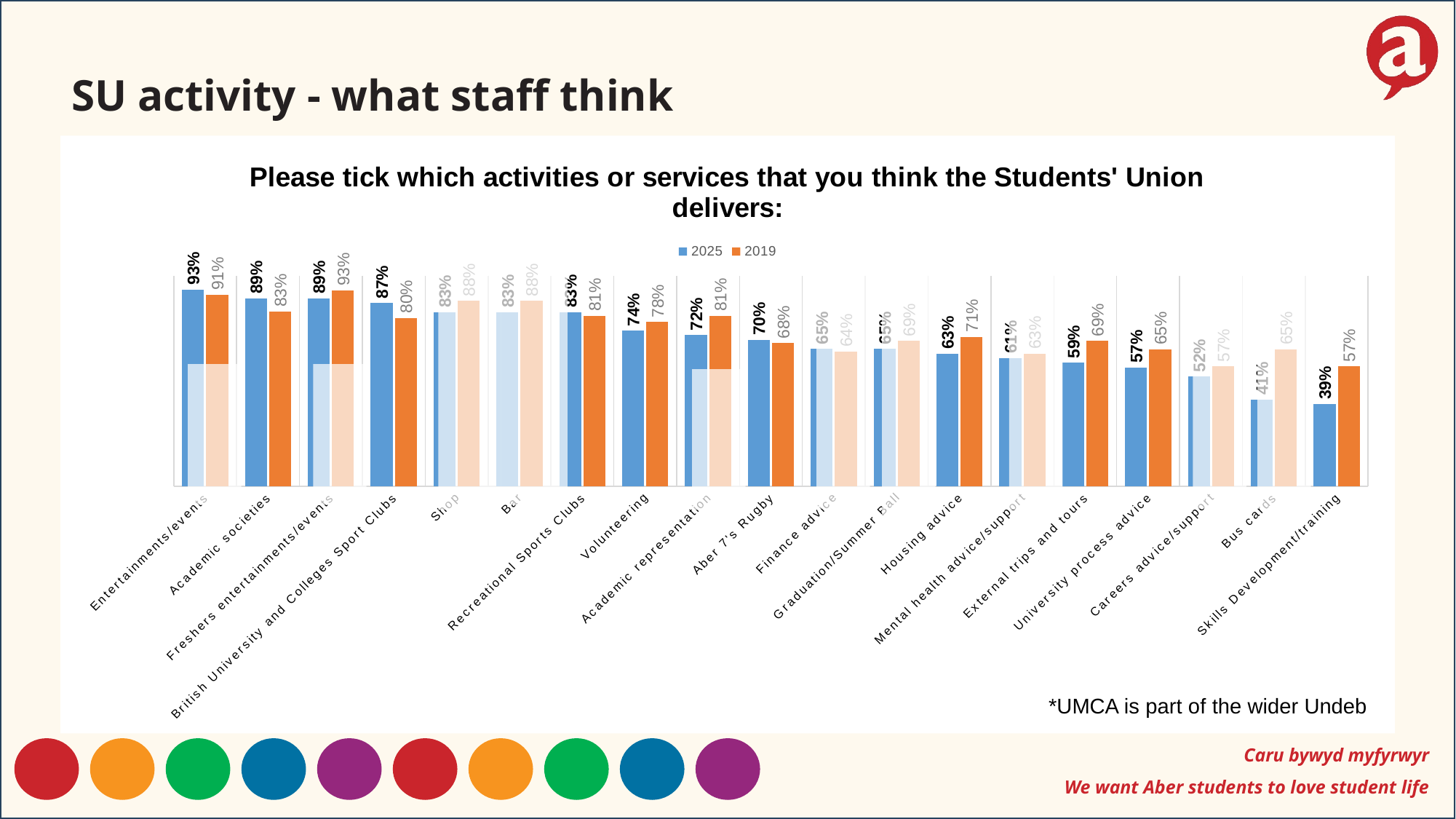
What is the difference between the 2019 and 2025 values for Bus cards? 24% How many series does the legend list? 2 What kind of chart is shown on the slide? Bar chart Which category has the lowest 2025 value? Skills Development/training What is the 2019 value for Skills Development/training? 57% What is the 2025 value for Housing advice? 63% For Academic representation, which year has the larger value, 2025 or 2019? 2019 What is the 2019 value for Bus cards? 65% Which category has the highest 2025 value? Entertainments/events Which colour represents the 2019 series in the legend? Orange What percentage of staff in 2025 thought the Students' Union delivers Volunteering? 74% How many categories are shown on the x axis? 19